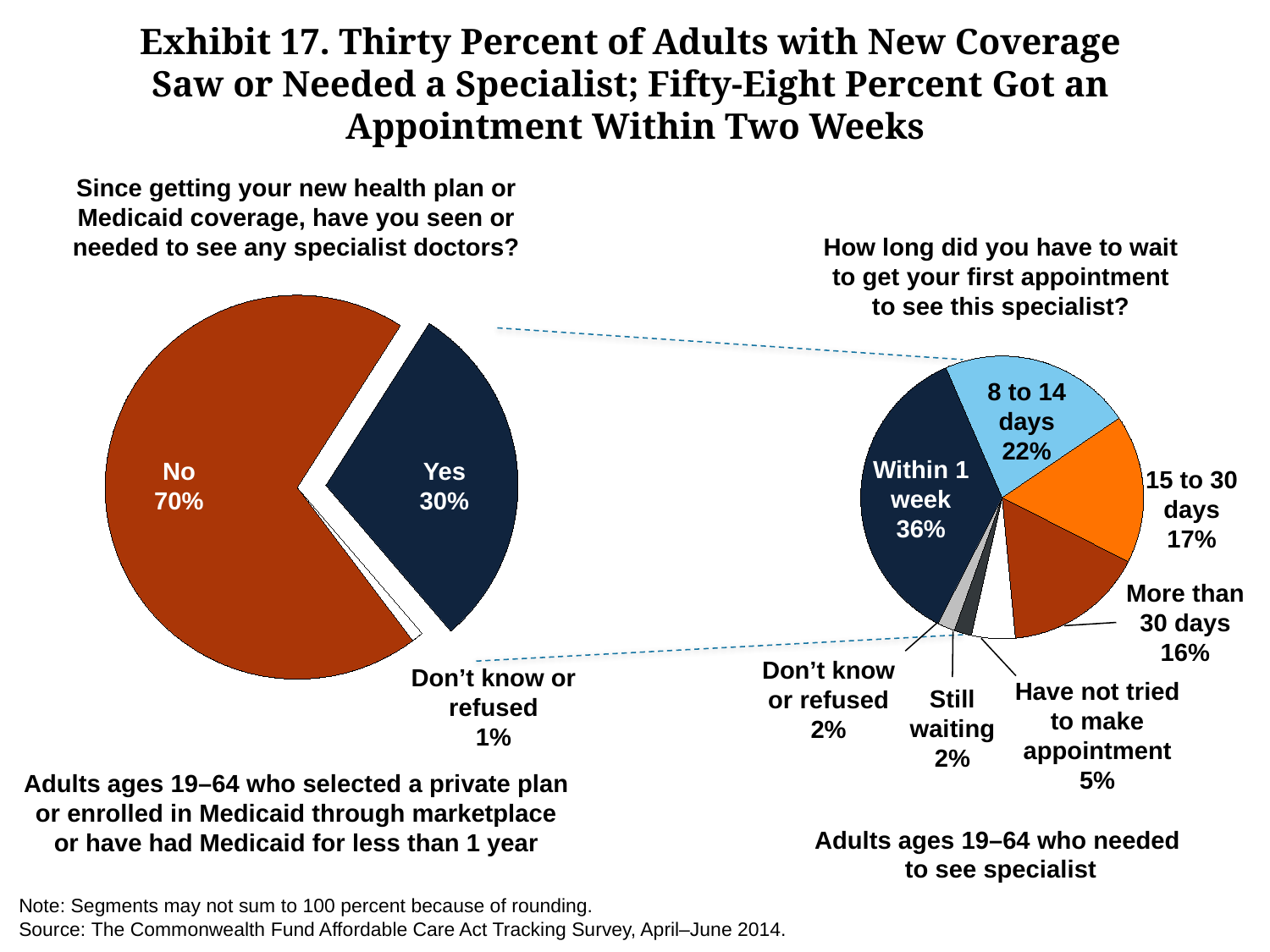
In the left pie chart (seen or needed to see specialist doctors), how many slices are there? 3 In the right pie chart (wait time for first specialist appointment), what share waited "Within 1 week"? 36% In the right pie chart (wait time for first specialist appointment), what share waited "8 to 14 days"? 22% In the left pie chart (seen or needed to see specialist doctors), what share of adults answered "Yes"? 30% In the left pie chart (seen or needed to see specialist doctors), which category has the largest share? No In the right pie chart (wait time for first specialist appointment), what share waited "More than 30 days"? 16% In the right pie chart (wait time for first specialist appointment), what is the difference between the "Within 1 week" share and the "15 to 30 days" share? 19 percentage points In the right pie chart (wait time for first specialist appointment), how many slices are there? 7 In the left pie chart (seen or needed to see specialist doctors), what share of adults answered "No"? 70% In the left pie chart (seen or needed to see specialist doctors), what share is "Don't know or refused"? 1% What type of chart is used on this slide? Pie chart In the right pie chart (wait time for first specialist appointment), which category has the largest share? Within 1 week